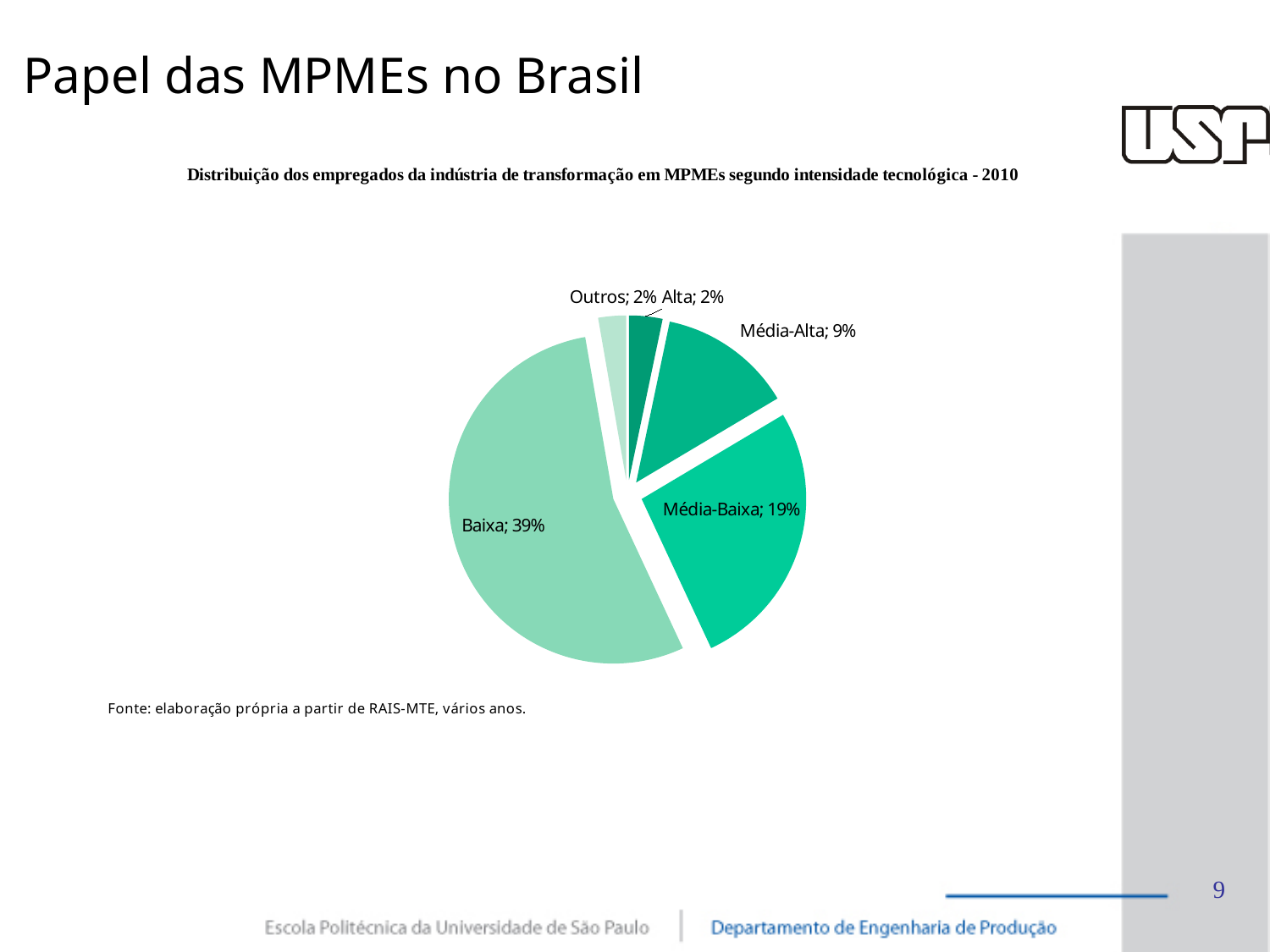
What year is referenced in the chart title? 2010 What is the difference in percentage points between the Média-Baixa slice and the Média-Alta slice? 10 percentage points What percentage is shown for the Média-Alta slice? 9% What percentage is shown for the Alta slice? 2% What percentage is shown for the Baixa slice? 39% How many slices does the pie chart have? 5 What kind of chart is shown on the slide? Pie chart Which category has the largest slice of the pie? Baixa What percentage is shown for the Média-Baixa slice? 19% What is the difference in percentage points between the Baixa slice and the Média-Baixa slice? 20 percentage points Which is larger, the Média-Alta slice or the Média-Baixa slice? Média-Baixa What percentage is shown for the Outros slice? 2%